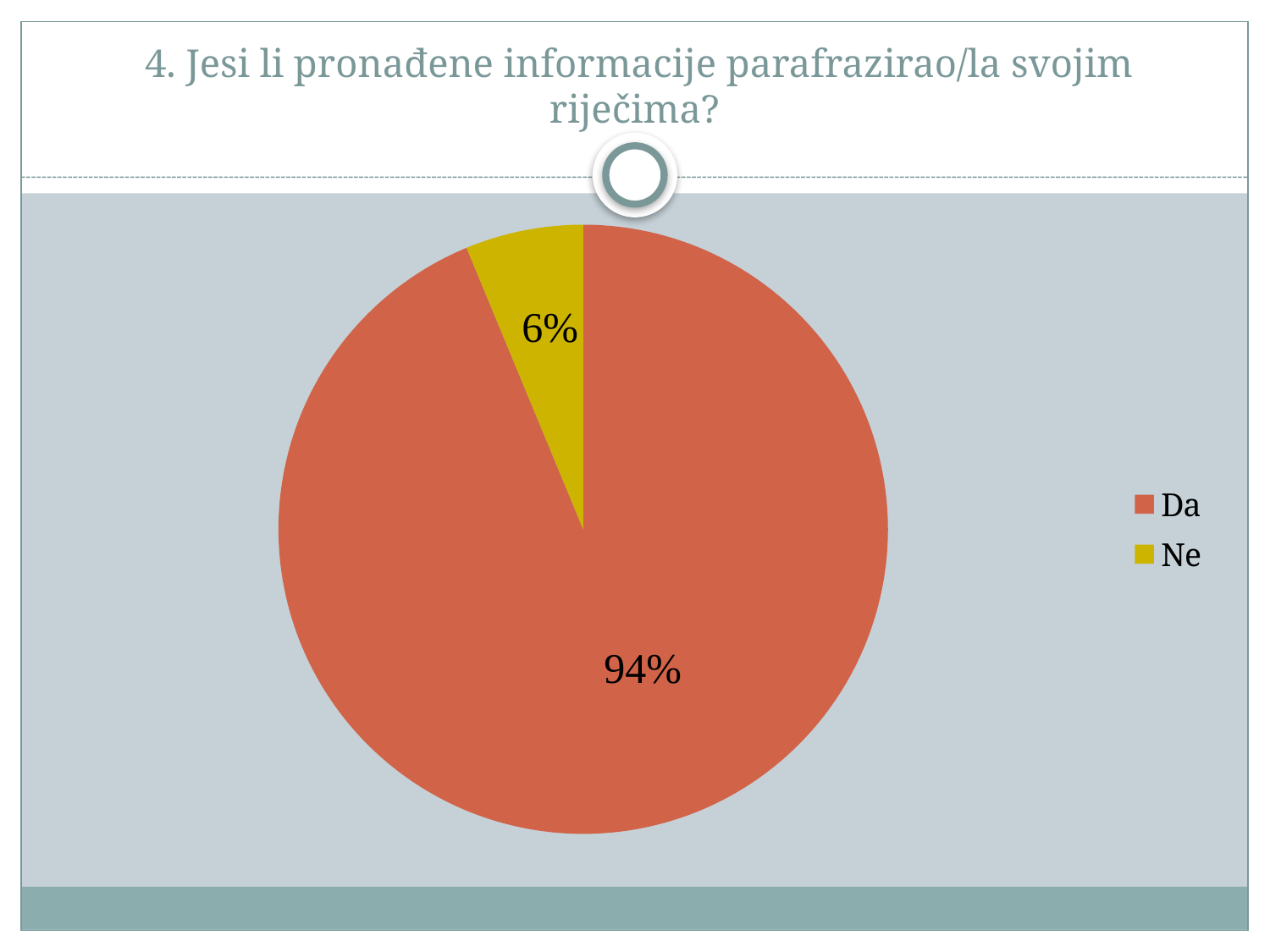
What is the difference in percentage points between the "Da" and "Ne" slices? 88 Which category has the largest slice of the pie? Da How many entries does the legend list? 2 What share of the pie does "Da" have? 94% Which category has the smallest slice of the pie? Ne What colour is the "Ne" slice? yellow What share of the pie does "Ne" have? 6% What is the title of the slide containing the chart? 4. Jesi li pronađene informacije parafrazirao/la svojim riječima? How many slices does the pie chart have? 2 What kind of chart is shown on the slide? pie chart Which slice is larger, "Da" or "Ne"? Da